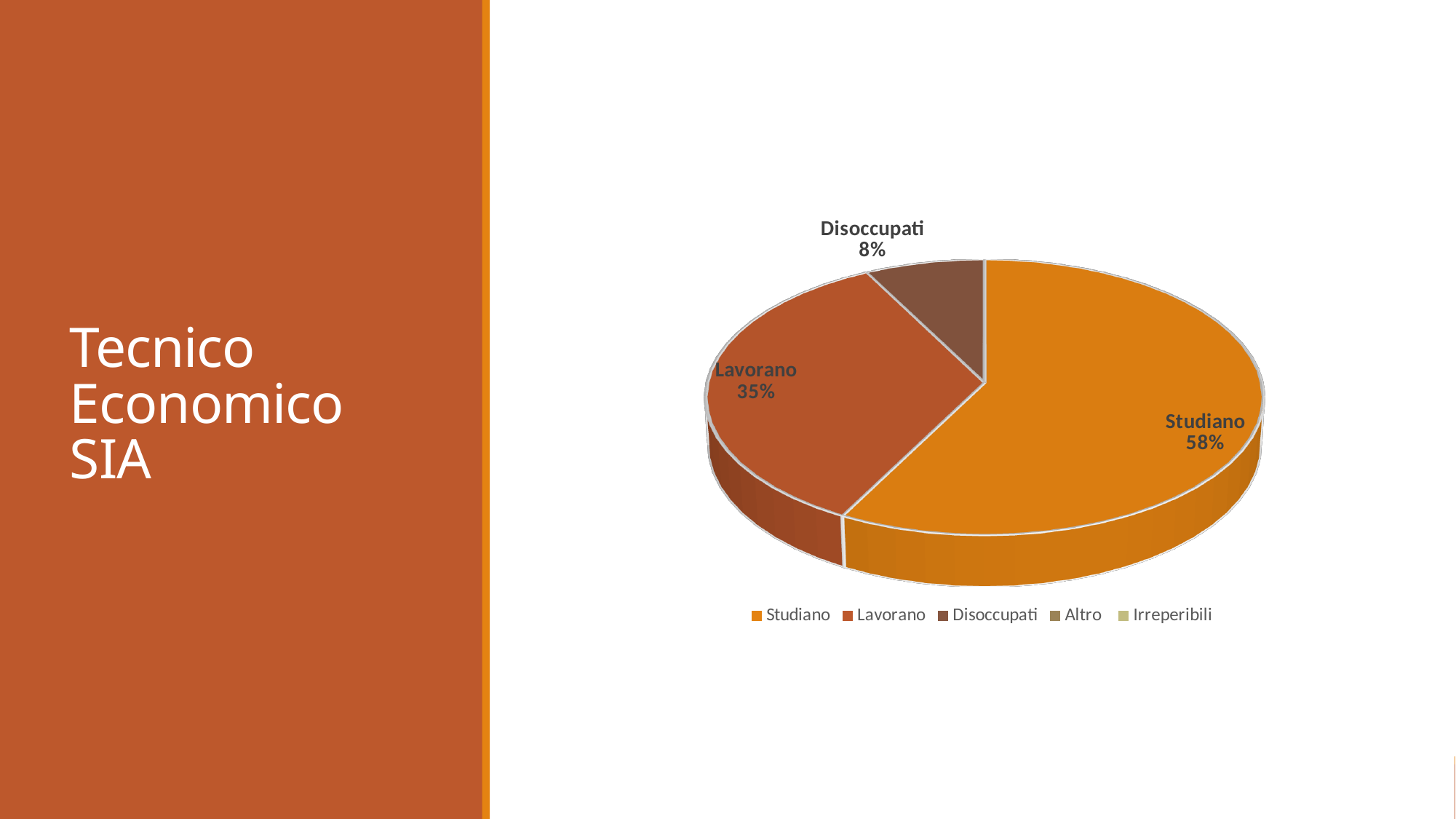
What share of the pie does Studiano have? 58% What is the difference in percentage points between Lavorano and Disoccupati? 27 What share of the pie does Disoccupati have? 8% How many slices have a percentage label printed on the chart? 3 What share of the pie does Lavorano have? 35% Which category has the largest slice of the pie? Studiano What kind of chart is shown on the slide? pie chart Which of the labelled slices is the smallest? Disoccupati What is the difference in percentage points between Studiano and Lavorano? 23 How many entries does the legend list? 5 Which is larger, the Lavorano slice or the Disoccupati slice? Lavorano What colour is the Studiano slice? orange